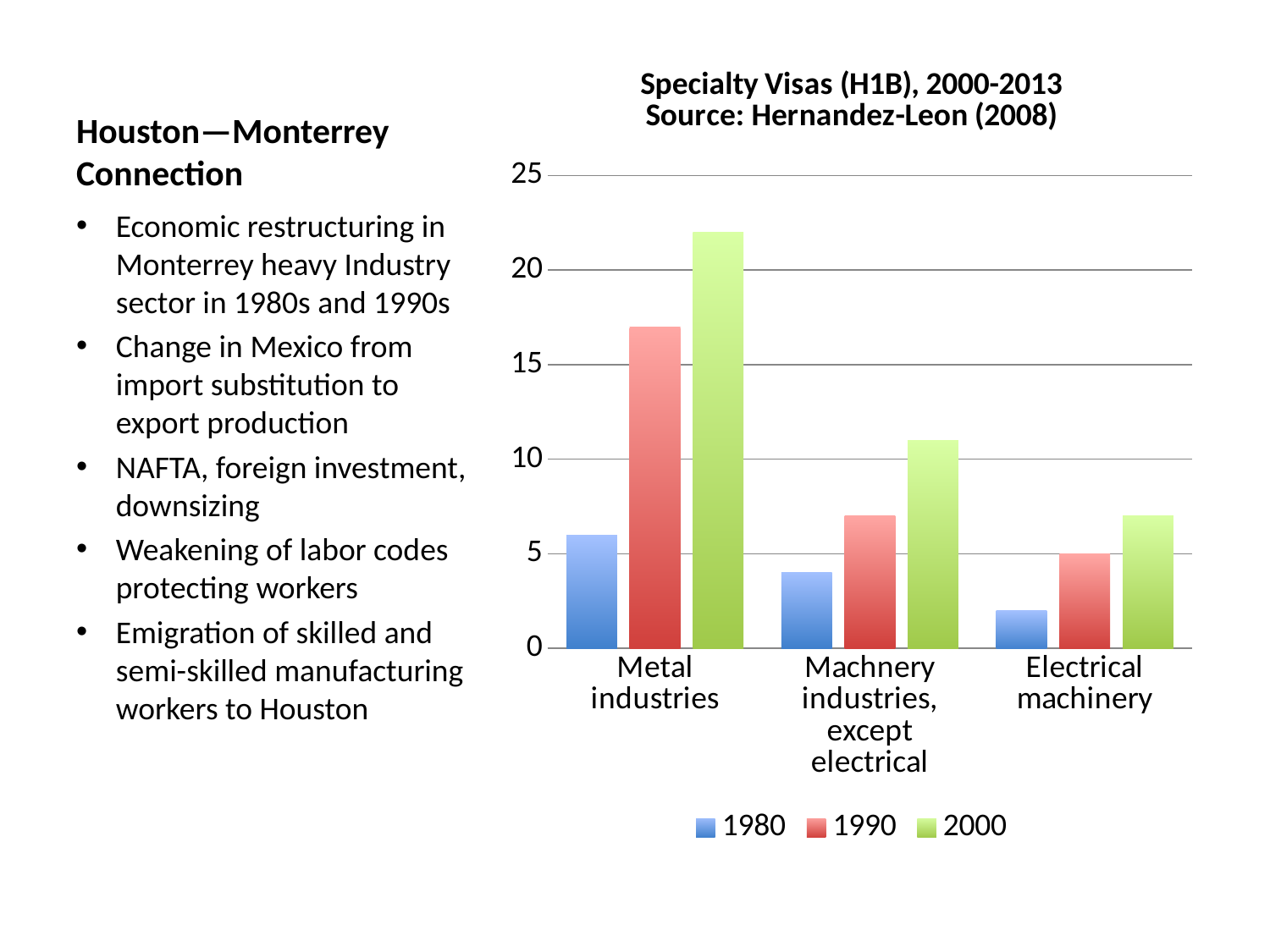
Is the value for Metal industries in 2000 greater or less than 20? greater Is the value for Electrical machinery in 1980 greater or less than 5? less For Electrical machinery, do the values rise or fall from 1980 to 2000? rise What kind of chart is shown on the slide? bar chart How many series does the legend list? 3 Is the value for Machnery industries, except electrical in 2000 greater or less than 10? greater Which is larger for Metal industries: the 1980 value or the 1990 value? 1990 Which industry category has the highest value for 2000? Metal industries What is the title of the chart? Specialty Visas (H1B), 2000-2013 Source: Hernandez-Leon (2008) How many industry categories are shown on the x axis? 3 Which industry category has the lowest value for 1980? Electrical machinery